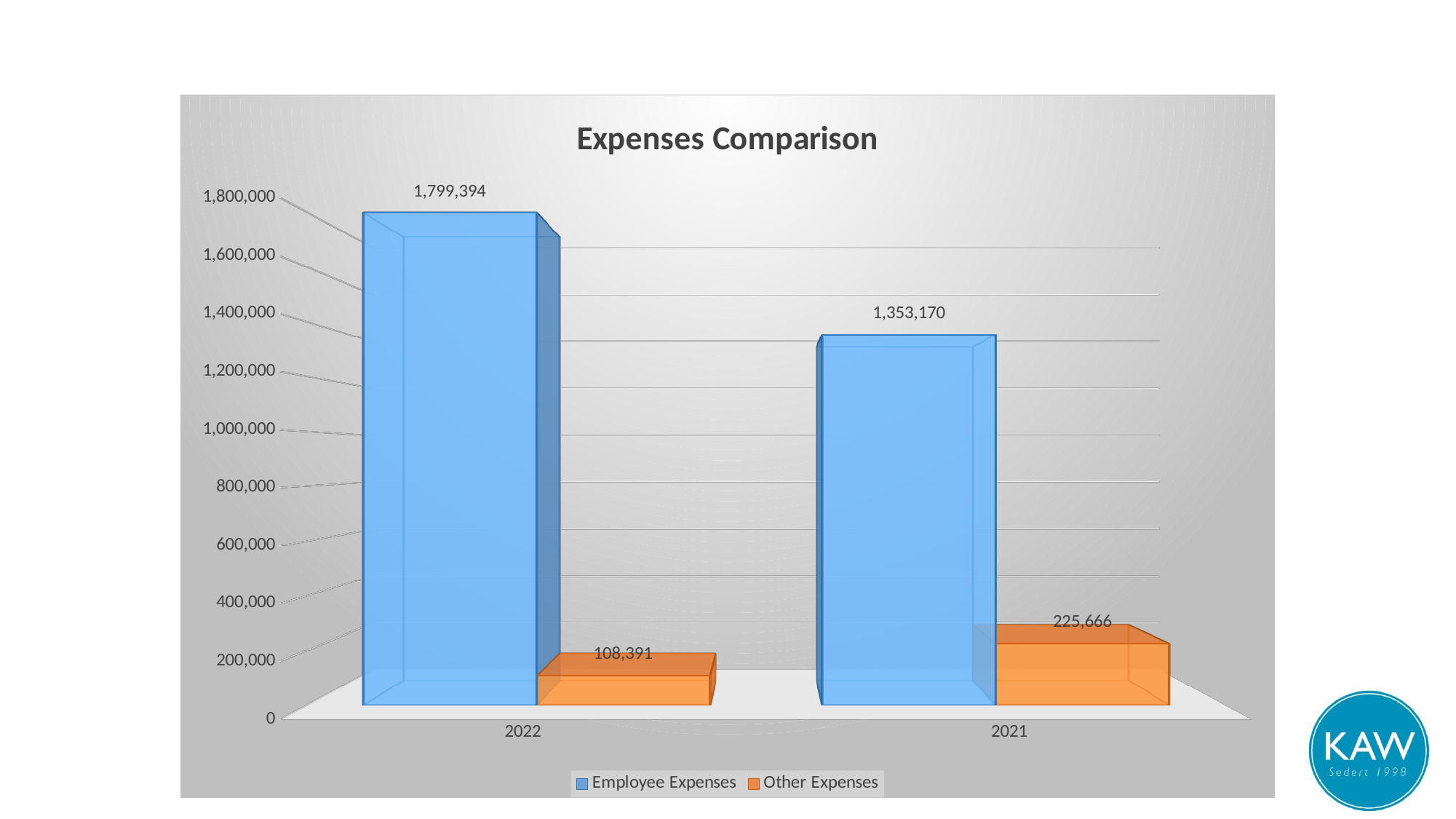
What is the value of Employee Expenses for 2022? 1,799,394 Which year has the lower Other Expenses? 2022 What is the difference between Employee Expenses in 2022 and 2021? 446,224 What kind of chart is shown on the slide? Bar chart What is the value of Other Expenses for 2021? 225,666 What is the value of Employee Expenses for 2021? 1,353,170 Which is larger: Other Expenses in 2021 or Other Expenses in 2022? Other Expenses in 2021 Which year has the higher Employee Expenses? 2022 What is the value of Other Expenses for 2022? 108,391 What is the title of the chart? Expenses Comparison How many series does the legend list? 2 What is the difference between Other Expenses in 2021 and 2022? 117,275